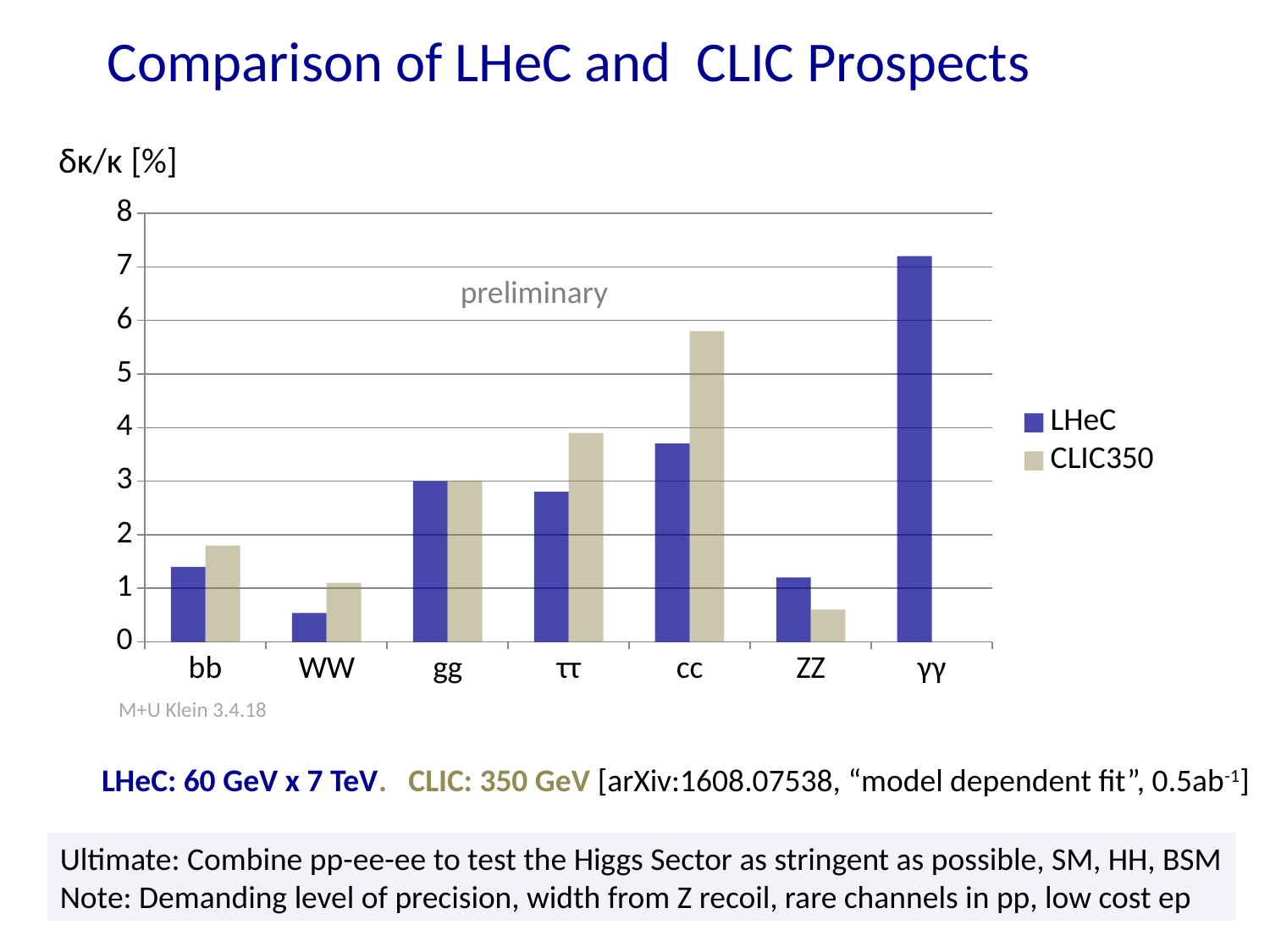
What kind of chart is shown on the slide? bar chart What are the two series names listed in the legend? LHeC and CLIC350 For ZZ, which series has the larger value, LHeC or CLIC350? LHeC How many categories are shown on the x axis? 7 Is the LHeC value for γγ greater or less than 7? greater Which category has the lowest LHeC value? WW Which category has the highest LHeC value? γγ Which category has the highest CLIC350 value? cc How many series does the legend list? 2 For bb, which series has the larger value, LHeC or CLIC350? CLIC350 Is the CLIC350 value for cc greater or less than 5? greater